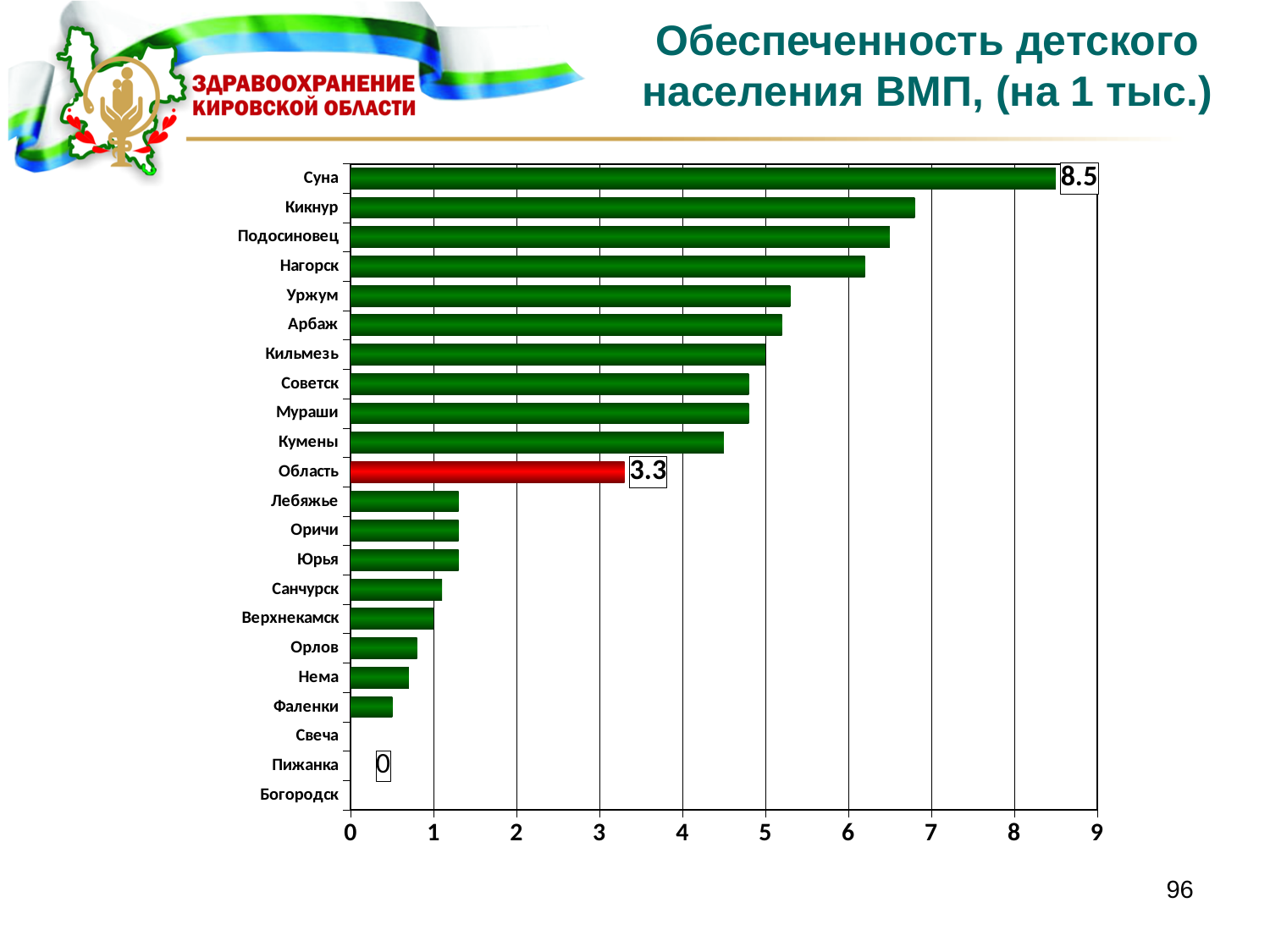
What kind of chart is shown on the slide? bar chart Is the value for Кикнур greater or less than 6? greater What is the value for Пижанка? 0 Which category's bar is coloured red? Область What is the value for Суна? 8.5 Is the value for Кумены greater or less than 5? less What is the value for Область? 3.3 How many categories are shown on the chart? 22 What is the difference between the values for Суна and Область? 5.2 Is the value for Фаленки greater or less than 1? less Which category has the highest value? Суна Which has a larger value, Кикнур or Нагорск? Кикнур